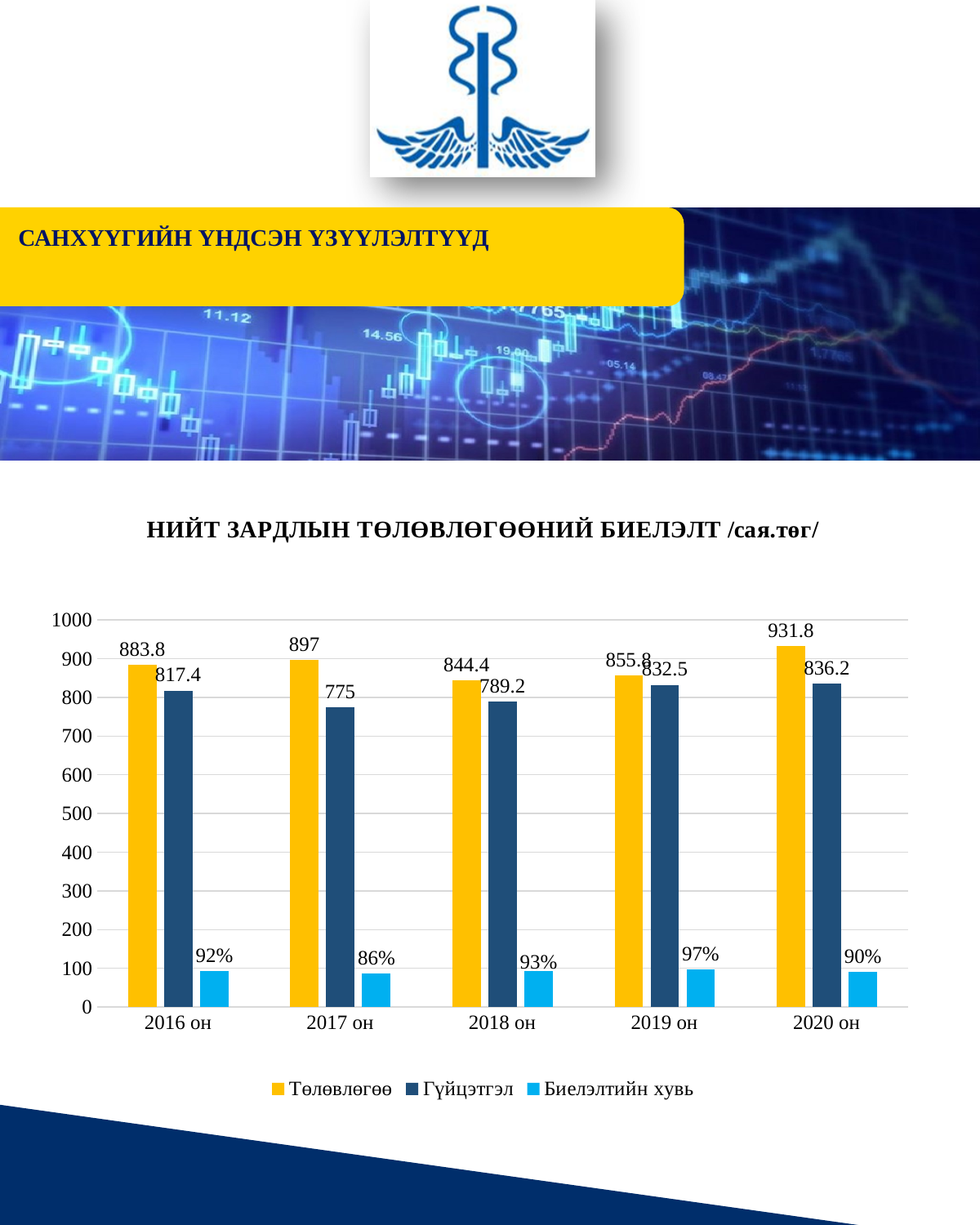
What is the difference between the Төлөвлөгөө and Гүйцэтгэл values for 2017 он? 122 How many series does the legend list? 3 What kind of chart is shown on the slide? bar chart What is the Төлөвлөгөө value for 2020 он? 931.8 What is the Биелэлтийн хувь value for 2019 он? 97% What is the Гүйцэтгэл value for 2017 он? 775 How many years are shown on the x axis? 5 Which year has the highest Төлөвлөгөө value? 2020 он Which year has the lowest Гүйцэтгэл value? 2017 он Which is larger, the Гүйцэтгэл value for 2019 он or for 2018 он? 2019 он Which year has the lowest Биелэлтийн хувь value? 2017 он Is the Гүйцэтгэл value for 2016 он greater or less than 800? greater